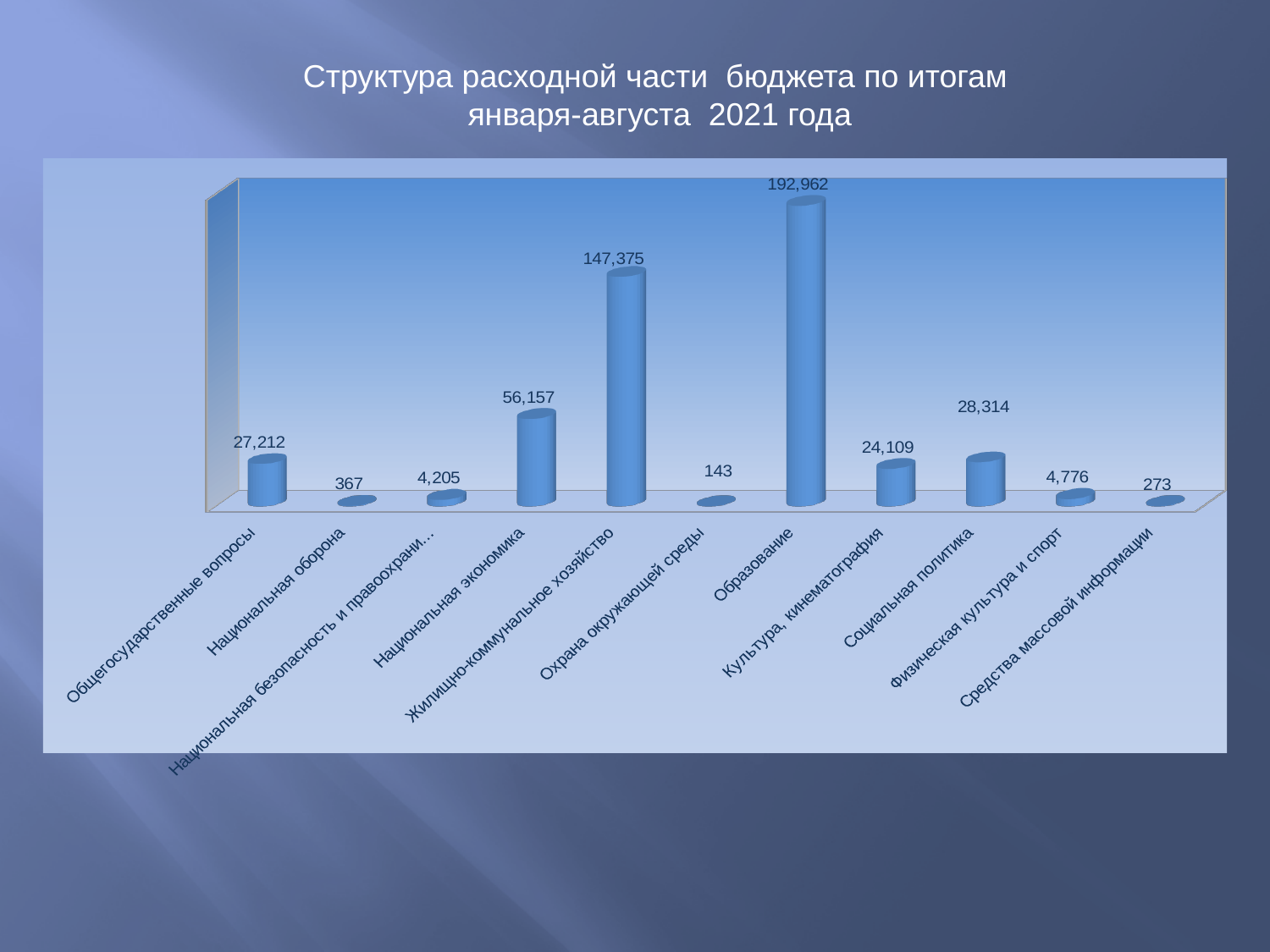
Which category has the highest value? Образование What is the difference between the values for Образование and Жилищно-коммунальное хозяйство? 45,587 Which is larger, the value for Социальная политика or the value for Культура, кинематография? Социальная политика What is the value for Социальная политика? 28,314 What kind of chart is shown on the slide? Bar chart What is the value for Охрана окружающей среды? 143 How many categories are shown on the chart? 11 What is the value for Национальная экономика? 56,157 What is the title of the slide? Структура расходной части бюджета по итогам января-августа 2021 года What is the value for Жилищно-коммунальное хозяйство? 147,375 Which category has the lowest value? Охрана окружающей среды What is the value for Образование? 192,962